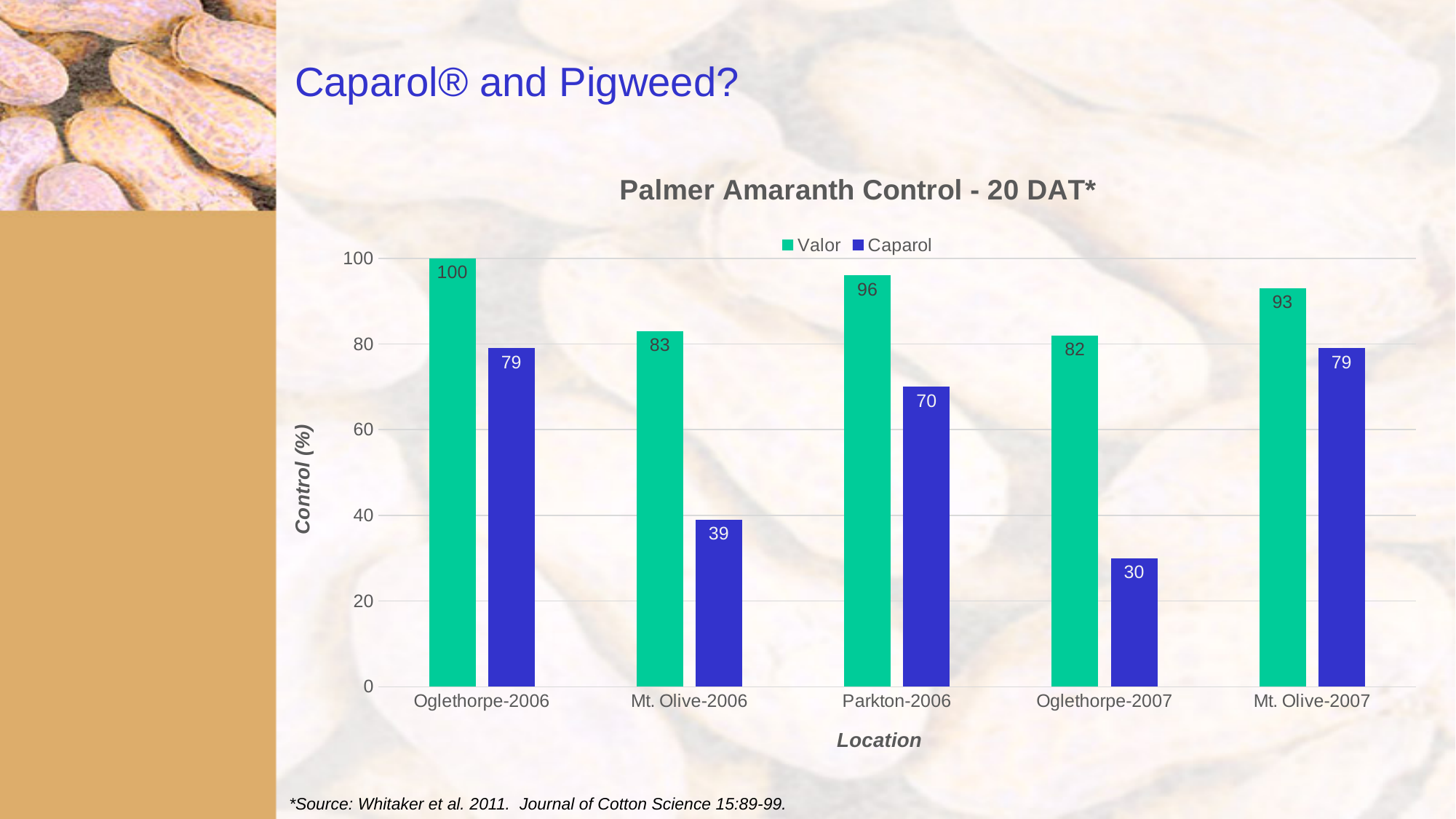
What is the Caparol control value at Parkton-2006? 70 What is the label of the y axis? Control (%) How many series does the legend list? 2 What is the title of the chart? Palmer Amaranth Control - 20 DAT* What kind of chart is shown? Bar chart What is the Caparol control value at Oglethorpe-2007? 30 Which location has the lowest Caparol control value? Oglethorpe-2007 What is the Valor control value at Oglethorpe-2006? 100 How many locations are shown on the x axis? 5 Which location has the highest Valor control value? Oglethorpe-2006 Which is larger at Mt. Olive-2007, the Valor value or the Caparol value? Valor What is the difference between the Valor and Caparol values at Mt. Olive-2006? 44